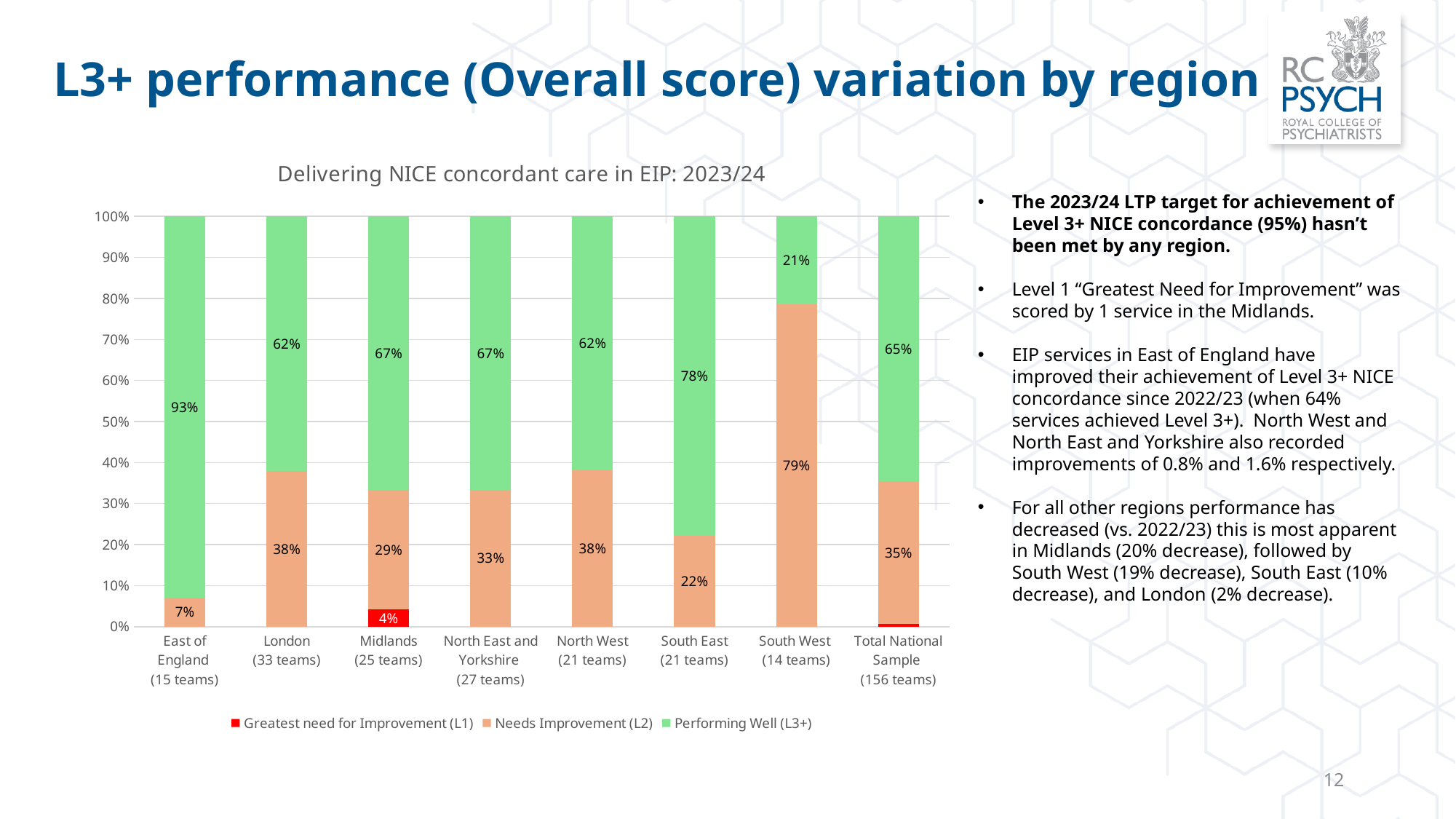
Is the Performing Well (L3+) value for the Total National Sample greater or less than 50%? greater What is the difference between the Performing Well (L3+) values for South East and London? 16% What is the Needs Improvement (L2) value for South West? 79% How many series does the legend list? 3 How many region categories are shown on the x axis, including the Total National Sample? 8 Which has a larger Needs Improvement (L2) value, North East and Yorkshire or North West? North West What is the title of the chart? Delivering NICE concordant care in EIP: 2023/24 Which region has the highest Performing Well (L3+) percentage? East of England What kind of chart is shown on the slide? Stacked bar chart What percentage of East of England teams are Performing Well (L3+)? 93% Which region has the lowest Performing Well (L3+) percentage? South West What is the Greatest need for Improvement (L1) value for Midlands? 4%